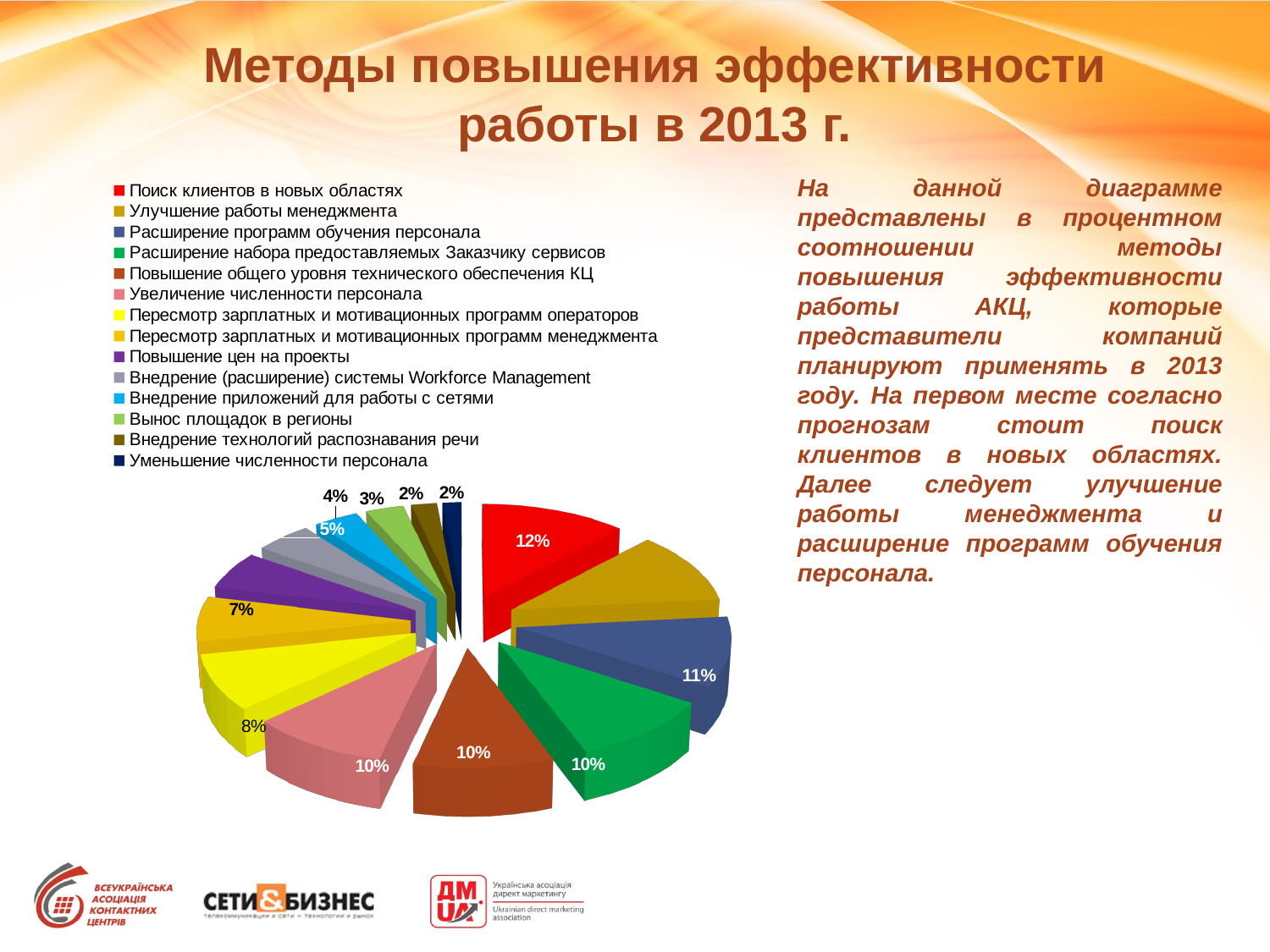
What share of the pie does 'Расширение набора предоставляемых Заказчику сервисов' have? 10% Which category has the largest share of the pie? Поиск клиентов в новых областях What colour is the slice for 'Поиск клиентов в новых областях'? red What share of the pie does 'Поиск клиентов в новых областях' have? 12% What is the difference in share between 'Поиск клиентов в новых областях' and 'Расширение программ обучения персонала'? 1% What share of the pie does 'Расширение программ обучения персонала' have? 11% What type of chart is shown on the slide? pie chart Which has a larger share: 'Поиск клиентов в новых областях' or 'Увеличение численности персонала'? Поиск клиентов в новых областях What share of the pie does 'Повышение общего уровня технического обеспечения КЦ' have? 10% What share of the pie does 'Увеличение численности персонала' have? 10% What is the title of the slide containing the pie chart? Методы повышения эффективности работы в 2013 г. How many categories does the pie chart's legend list? 14